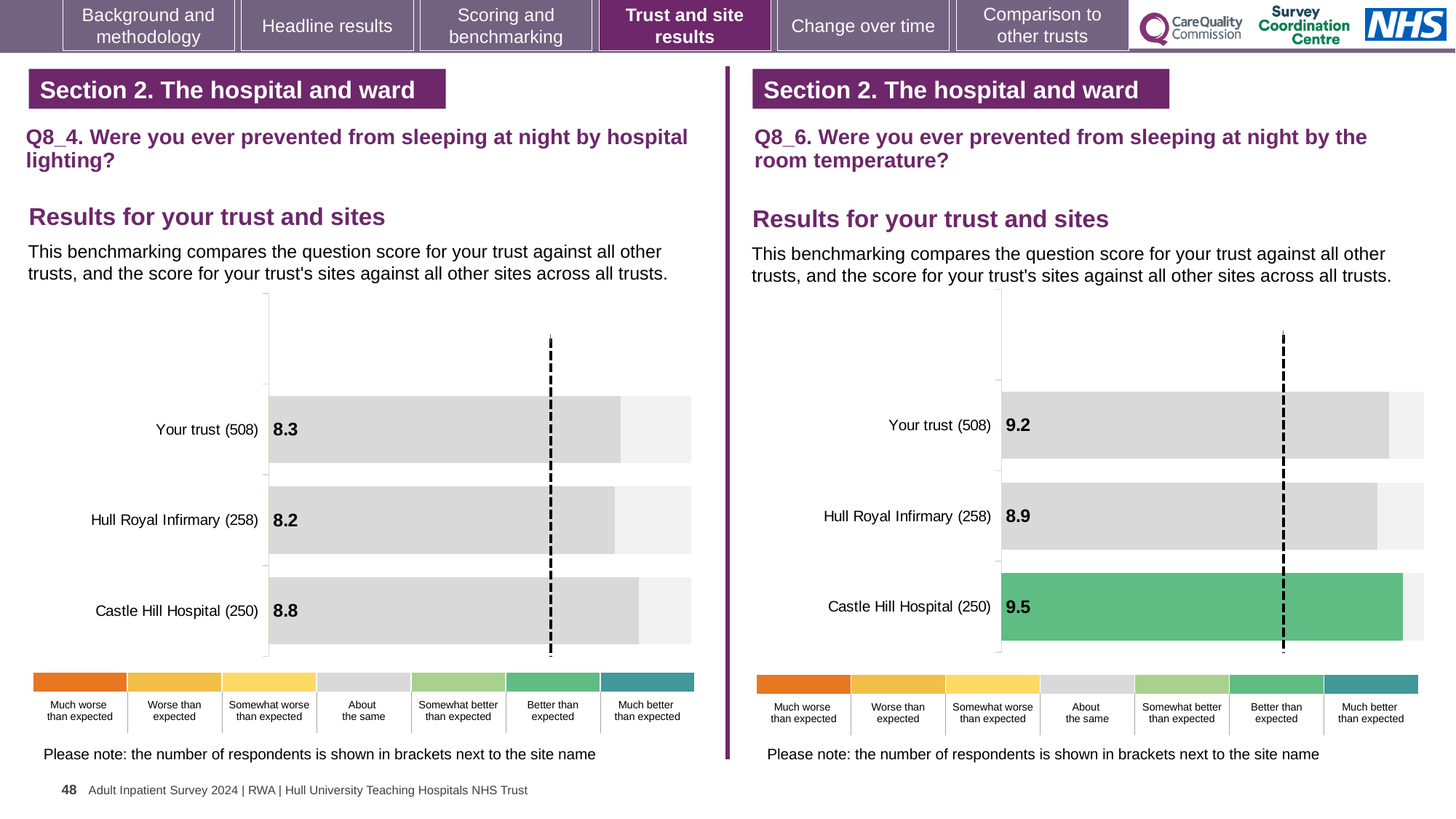
On the Q8_6 room temperature chart, what is the score for Your trust (508)? 9.2 On the Q8_4 hospital lighting chart, what is the score for Castle Hill Hospital (250)? 8.8 On the Q8_4 hospital lighting chart, which site or trust has the lowest score? Hull Royal Infirmary (258) On the Q8_4 hospital lighting chart, how many bars are plotted? 3 On the Q8_4 hospital lighting chart, what is the score for Your trust (508)? 8.3 On the Q8_4 hospital lighting chart, what is the difference between the scores for Castle Hill Hospital (250) and Hull Royal Infirmary (258)? 0.6 On the Q8_6 room temperature chart, which site or trust has the highest score? Castle Hill Hospital (250) On the Q8_6 room temperature chart, what is the score for Hull Royal Infirmary (258)? 8.9 On the Q8_6 room temperature chart, what is the difference between the scores for Castle Hill Hospital (250) and Your trust (508)? 0.3 On the Q8_6 room temperature chart, which benchmark category does the green colour of the Castle Hill Hospital (250) bar represent? Better than expected What type of chart is used on the Q8_6 room temperature chart? Bar chart Which is larger: the Castle Hill Hospital (250) score on the Q8_4 hospital lighting chart or on the Q8_6 room temperature chart? Q8_6 room temperature chart